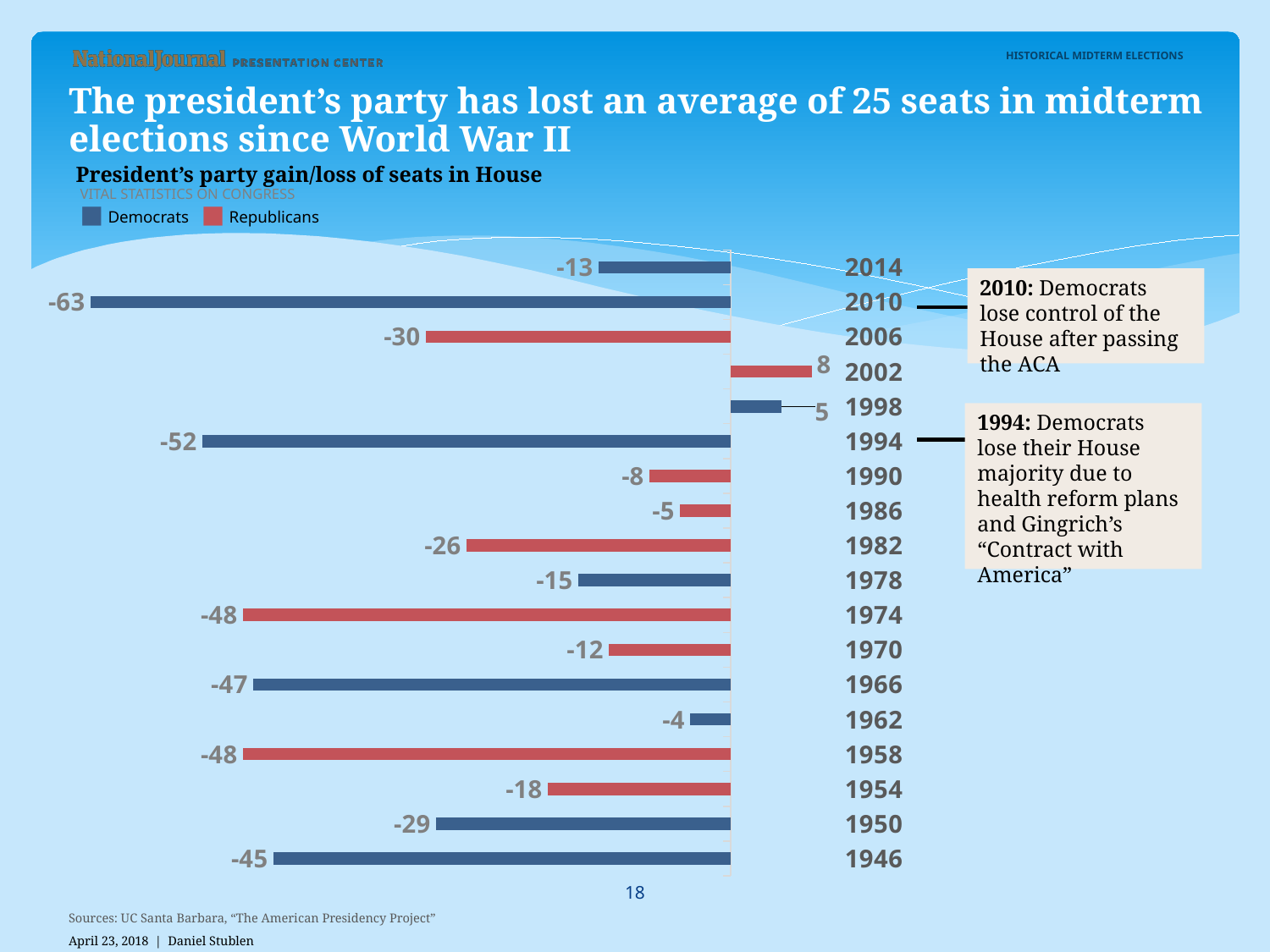
What is the value for 2002? 8 What is the value for 1994? -52 Which year shows the highest value on the chart? 2002 Which year has a larger loss of seats, 1974 or 1966? 1974 What kind of chart is shown on the slide? Bar chart How many midterm election years are shown on the chart? 18 Which year shows the largest loss of seats for the president's party? 2010 Which colour represents Republicans in the chart? Red What is the value for 2010? -63 What is the value for 1962? -4 How many series does the legend list? 2 What is the difference between the values for 2010 and 2014? 50